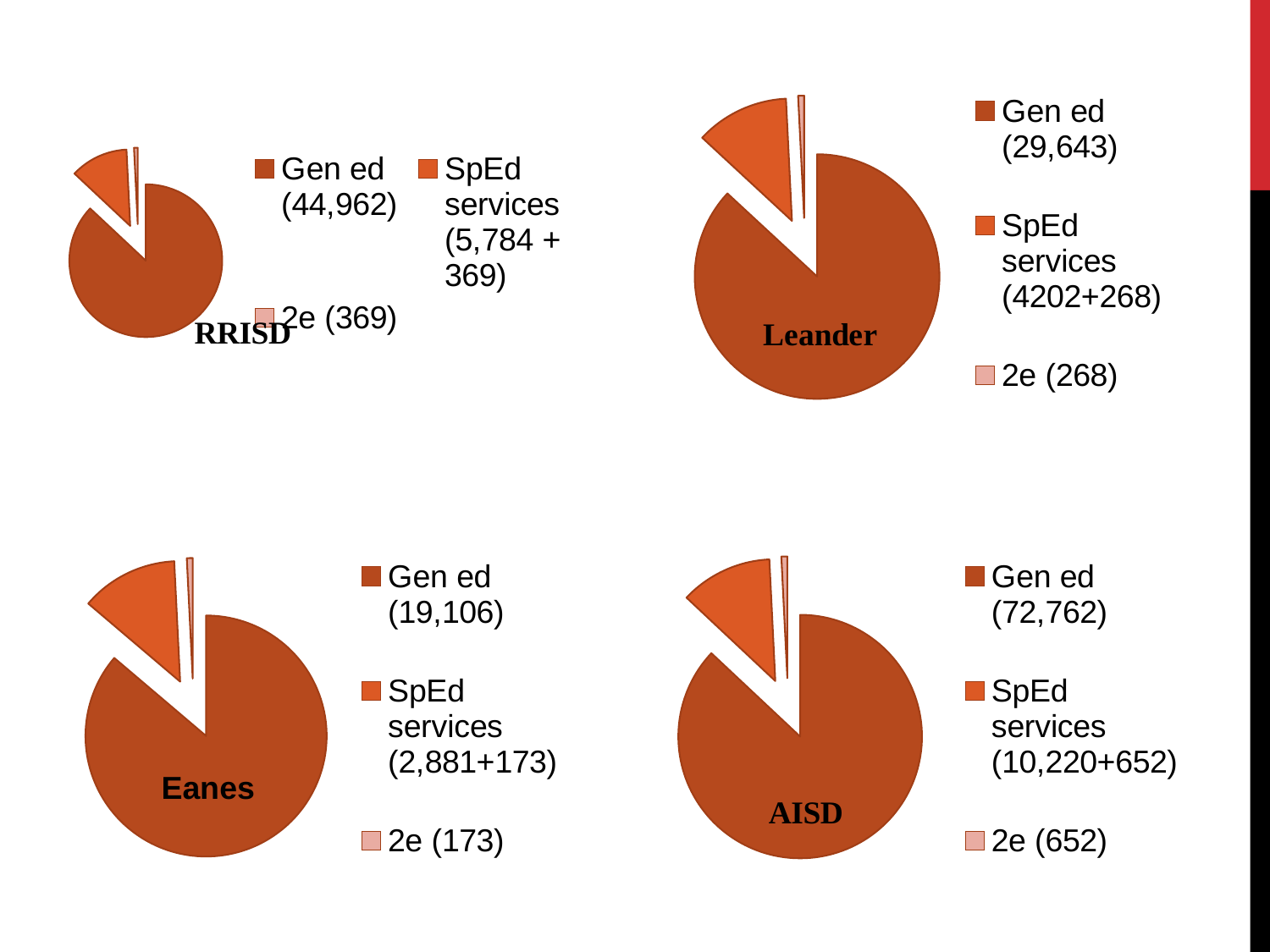
In the Leander chart, what value is given for 2e in the legend? 268 How many pie charts are shown on the slide? 4 In the AISD chart, what value is given for 2e in the legend? 652 In the RRISD chart, which category has the smallest slice? 2e In the AISD chart, which category has the largest slice? Gen ed In the Leander chart, what value is given for Gen ed in the legend? 29,643 In the Eanes chart, what value is given for Gen ed in the legend? 19,106 Which chart shows a larger Gen ed value, AISD or RRISD? AISD What kind of chart is the RRISD chart? pie chart In the RRISD chart, what value is given for Gen ed in the legend? 44,962 In the Leander chart, how many entries does the legend list? 3 What is the difference between the Gen ed value in the AISD chart and the Gen ed value in the Leander chart? 43,119